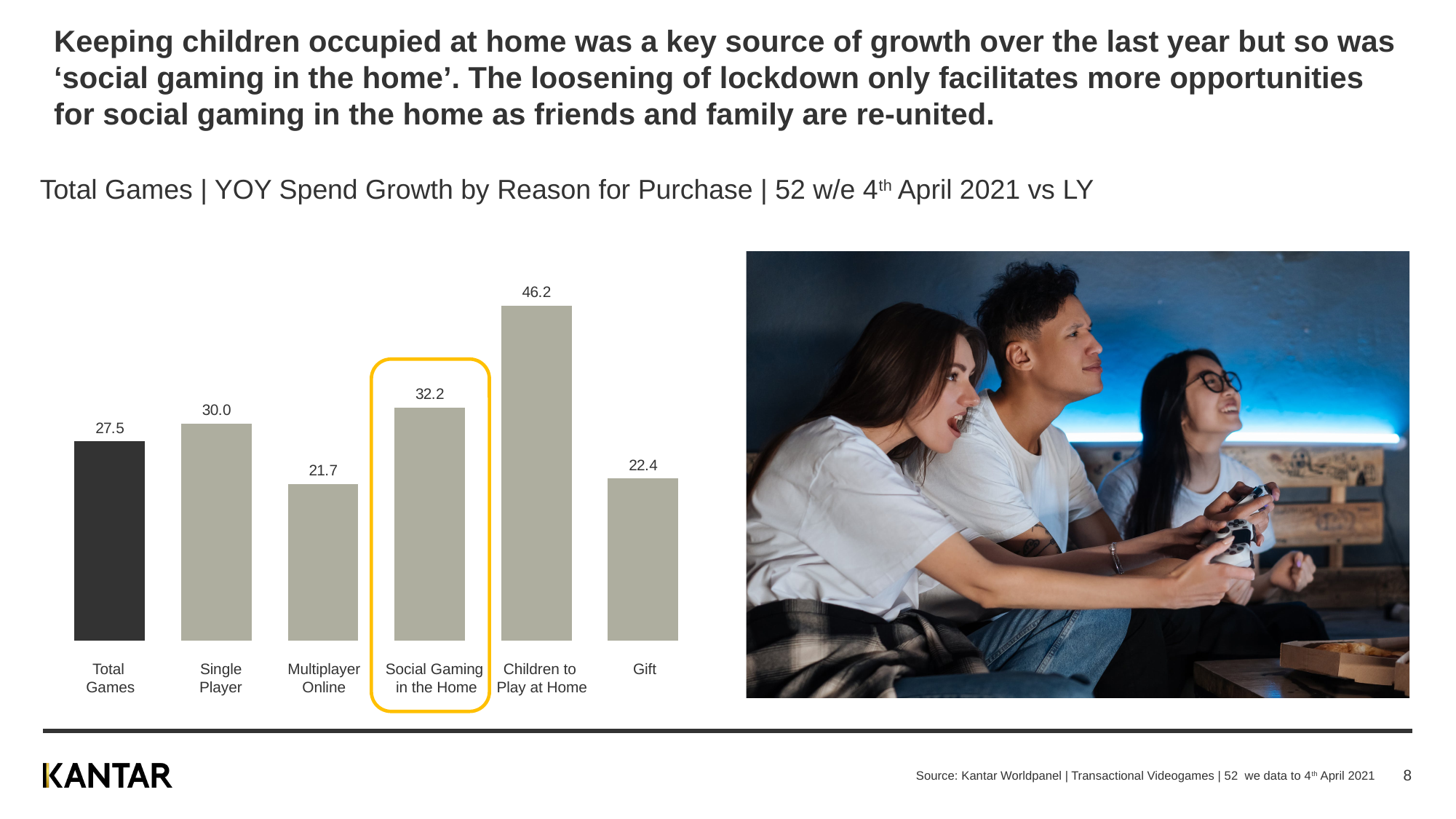
What kind of chart is shown on the slide? Bar chart Which category is highlighted with a yellow outline on the chart? Social Gaming in the Home What is the value shown for Gift? 22.4 What is the difference between the values for Children to Play at Home and Social Gaming in the Home? 14.0 Which is larger, the value for Single Player or the value for Gift? Single Player What is the value shown for Social Gaming in the Home? 32.2 What is the difference between the values for Single Player and Multiplayer Online? 8.3 Which category has the lowest value on the chart? Multiplayer Online Which reason for purchase has the highest YOY spend growth? Children to Play at Home What is the value shown for Total Games? 27.5 What is the YOY spend growth value for Children to Play at Home? 46.2 How many categories are shown on the chart? 6